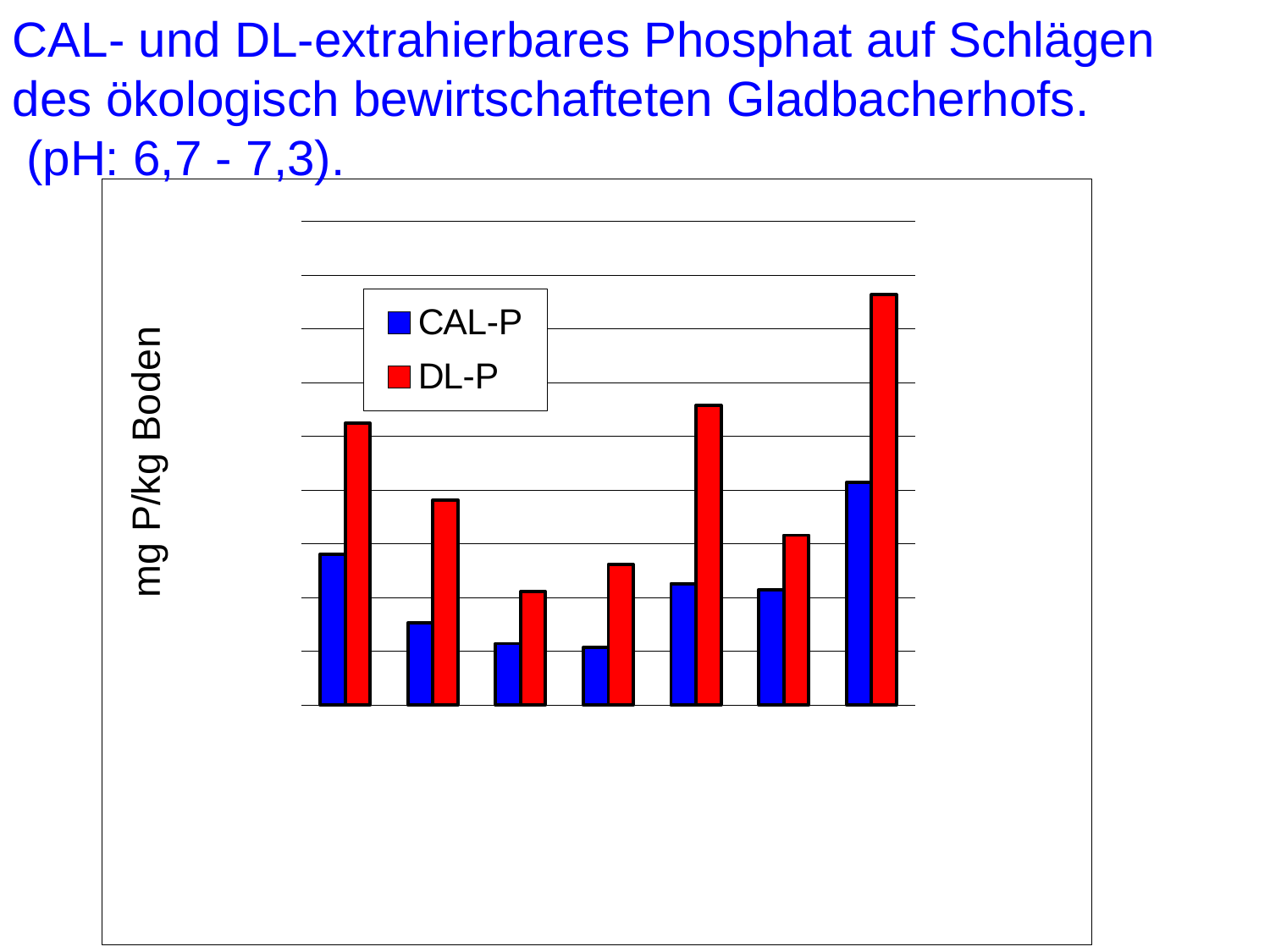
Which group of bars has the highest DL-P value? the seventh (rightmost) group Which series is shown in blue? CAL-P In the first group from the left, which series has the larger value, CAL-P or DL-P? DL-P Which group has the larger DL-P value, the second group or the sixth group from the left? the second group Is the DL-P bar higher than the CAL-P bar in every group? yes How many series does the legend list? 2 Which group of bars has the lowest DL-P value? the third group from the left What is the label of the y axis? mg P/kg Boden How many groups of bars (categories) are plotted along the x axis? 7 Which group of bars has the highest CAL-P value? the seventh (rightmost) group What kind of chart is shown on the slide? bar chart